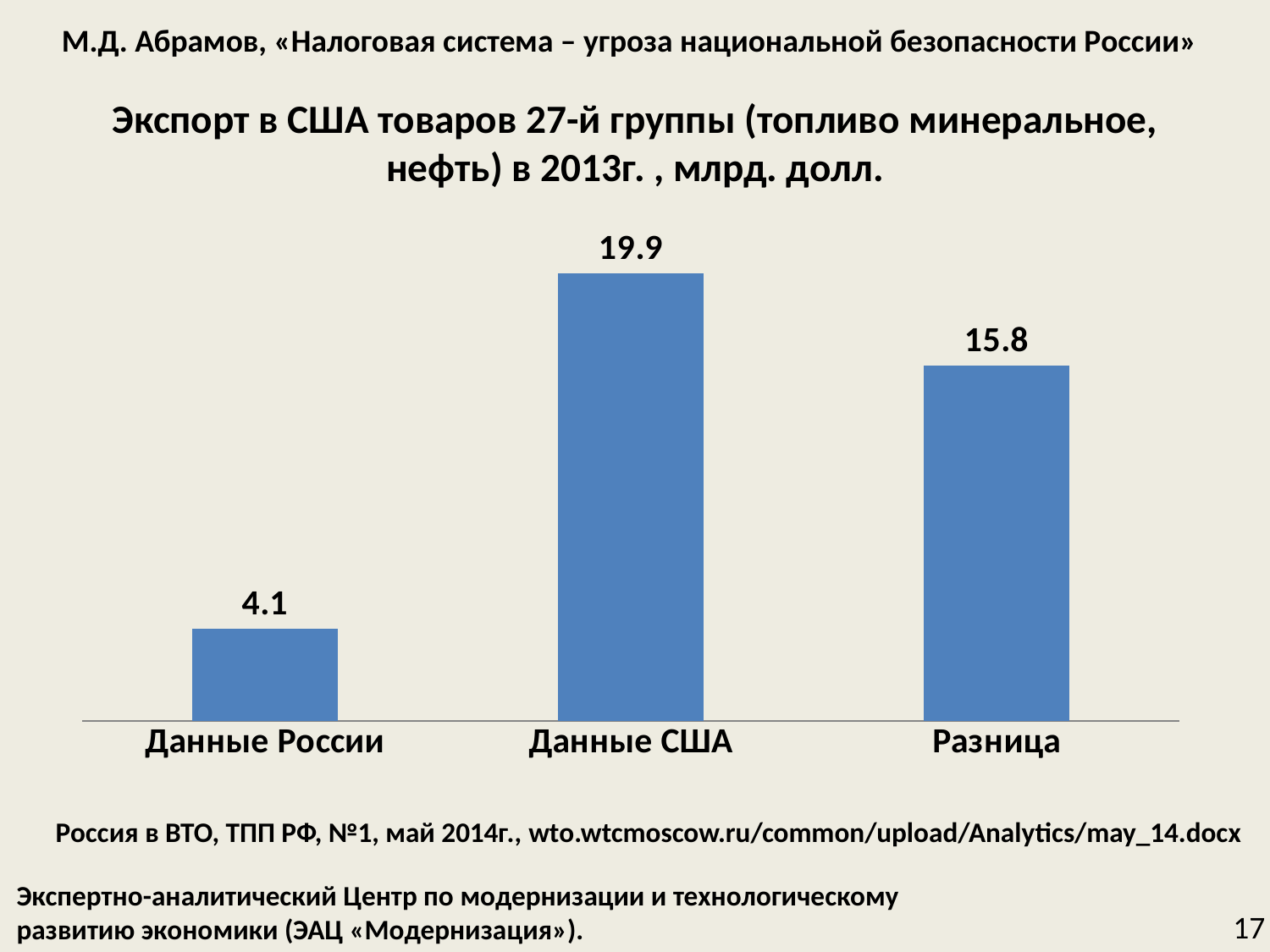
Which category has the highest value? Данные США Which is larger, the value for Разница or the value for Данные России? Разница What is the value for Данные США? 19.9 How many categories are shown in the chart? 3 What is the value for Разница? 15.8 What year does the chart title refer to? 2013 What is the difference between the values for Данные США and Разница? 4.1 What is the value for Данные России? 4.1 What kind of chart is shown on the slide? Bar chart Which category has the lowest value? Данные России What is the difference between the values for Данные США and Данные России? 15.8 What unit is stated in the chart title? млрд. долл.